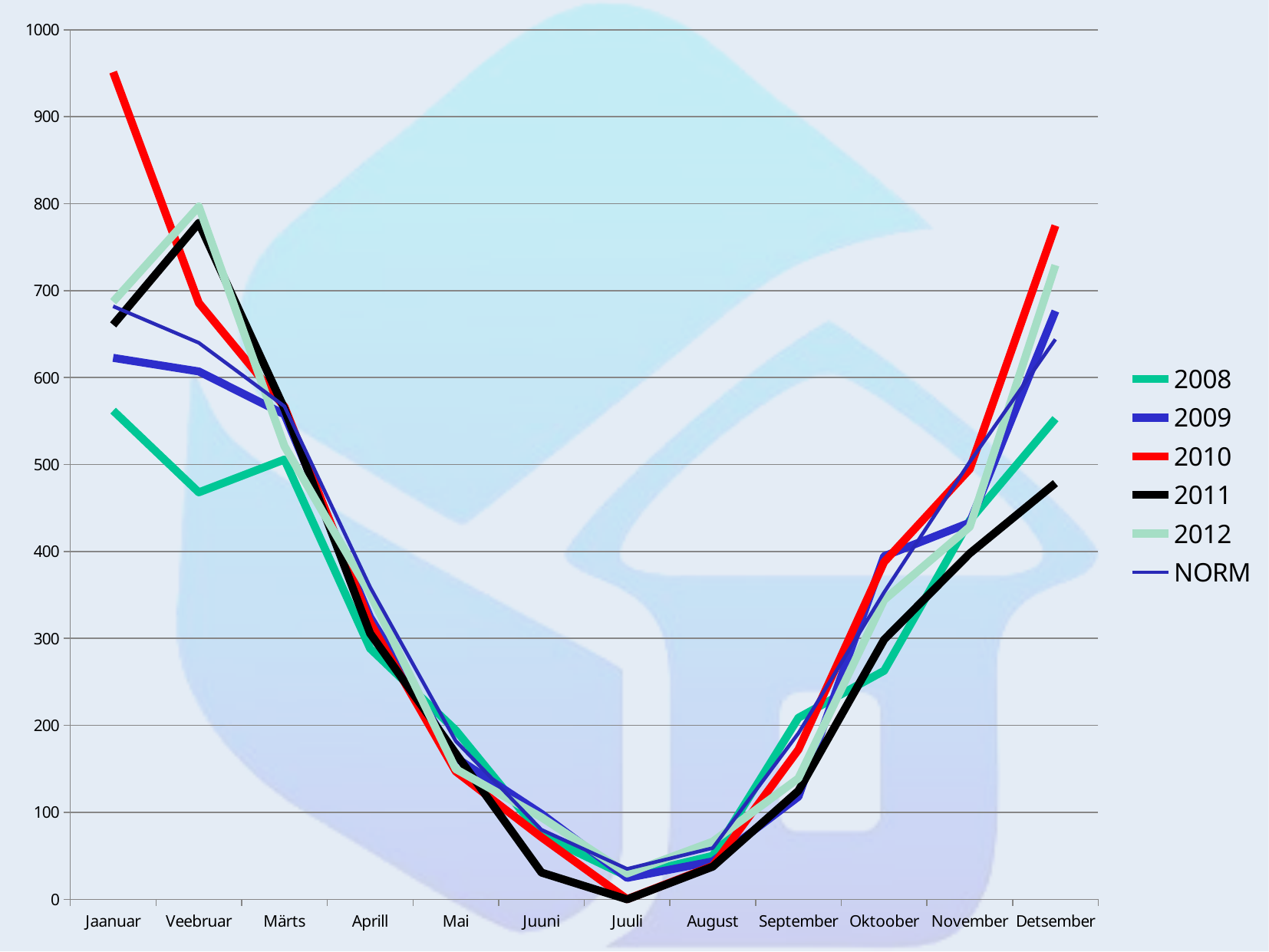
How many series does the legend list? 6 In which month does the 2011 series reach its lowest value? Juuli In Detsember, which is larger: the value for 2010 or the value for 2011? 2010 Is the value for 2008 in Veebruar greater or less than 500? less How many months are shown along the x axis? 12 What kind of chart is shown on the slide? line chart Which series has the highest value in Jaanuar? 2010 Which series has the lowest value in Jaanuar? 2008 Which series has the highest value in Detsember? 2010 Does the 2010 line rise or fall from Jaanuar to Juuli? fall Is the value for 2010 in Jaanuar greater or less than 900? greater What colour is the line for the 2010 series? red